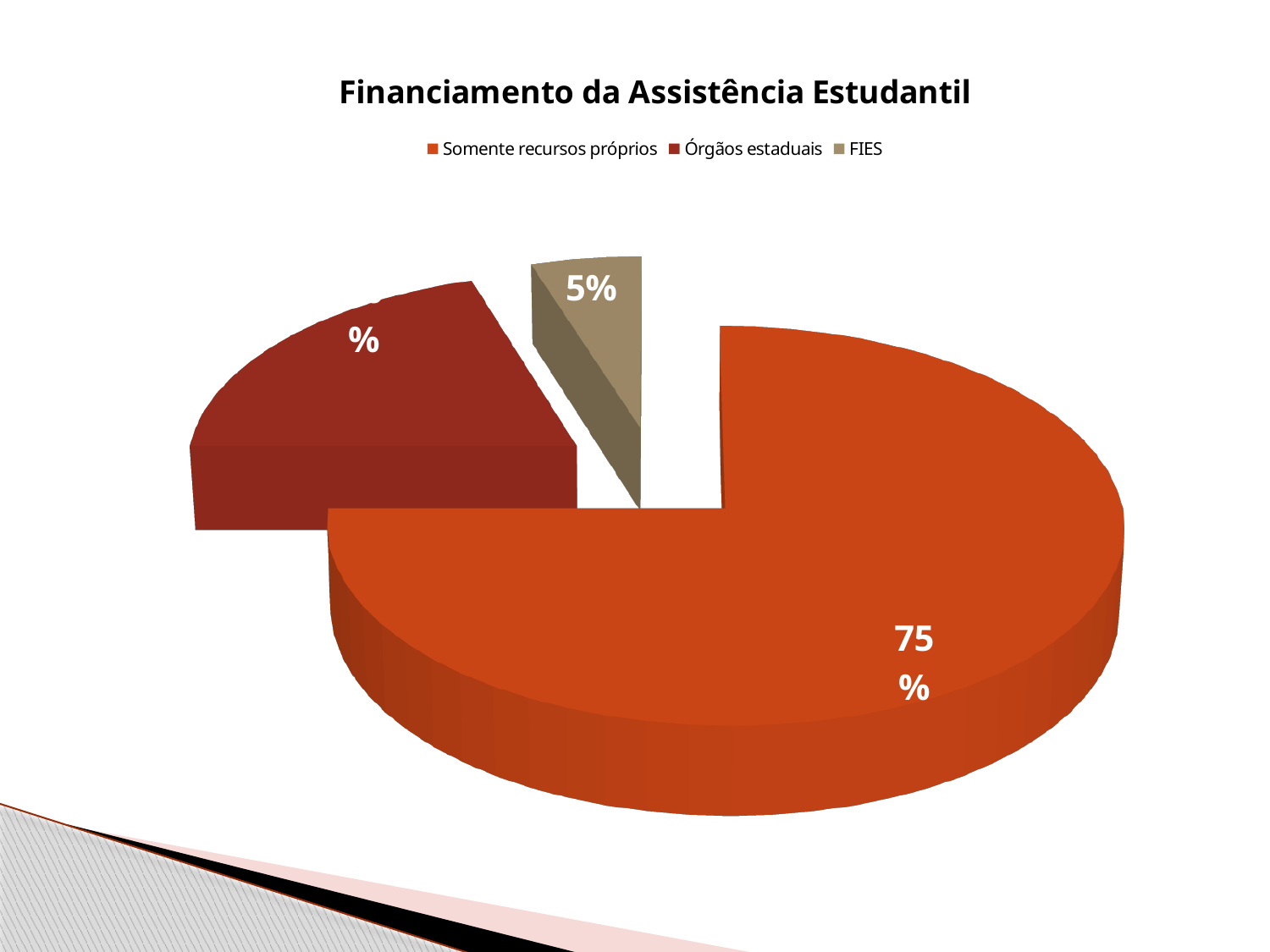
Which is larger, the slice for "Órgãos estaduais" or the slice for FIES? Órgãos estaduais What kind of chart is shown on the slide? Pie chart What is the difference between the share for "Somente recursos próprios" and the share for FIES? 70% Which is larger, the slice for "Somente recursos próprios" or the slice for FIES? Somente recursos próprios How many categories does the legend of the pie chart list? 3 Which category has the smallest slice of the pie? FIES Which legend entry is shown in the tan/beige colour? FIES Which category has the largest slice of the pie? Somente recursos próprios What is the value shown for the FIES slice? 5% What is the title of the chart? Financiamento da Assistência Estudantil What share of the pie does "Somente recursos próprios" represent? 75%